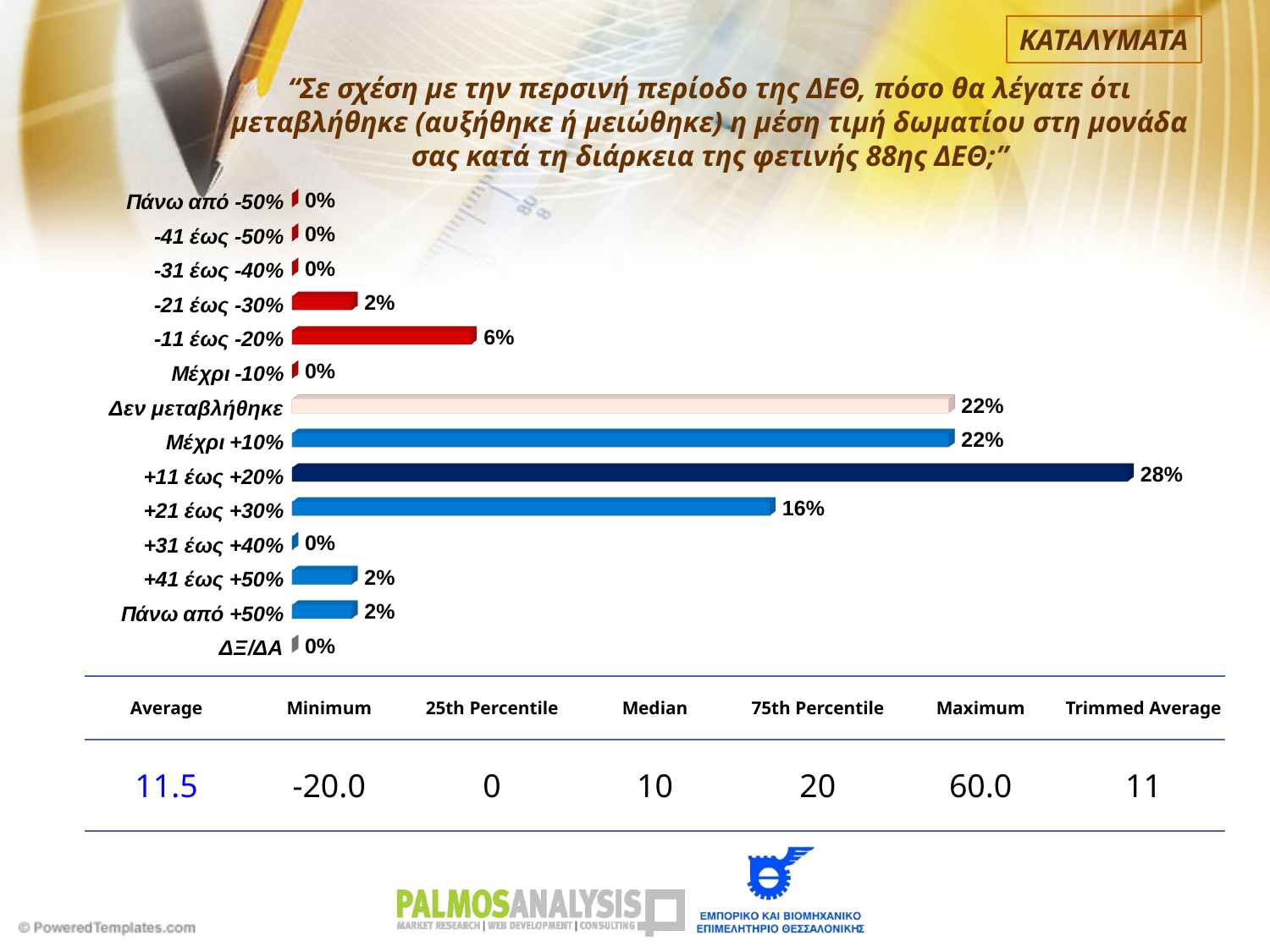
What is the difference between the values for '+11 έως +20%' and 'Μέχρι +10%'? 6% What kind of chart is shown on the slide? bar chart What is the value for the category '+21 έως +30%'? 16% Which is larger, the value for '+21 έως +30%' or the value for '-11 έως -20%'? +21 έως +30% What is the value for the category '-11 έως -20%'? 6% What is the value for the category '+11 έως +20%'? 28% How many categories does the bar chart show? 14 What is the difference between the values for '+21 έως +30%' and '-21 έως -30%'? 14% What is the value for the category 'ΔΞ/ΔΑ'? 0% Which category has the highest value in the bar chart? +11 έως +20% What is the value for the category 'Πάνω από +50%'? 2% What is the value for the category 'Δεν μεταβλήθηκε'? 22%